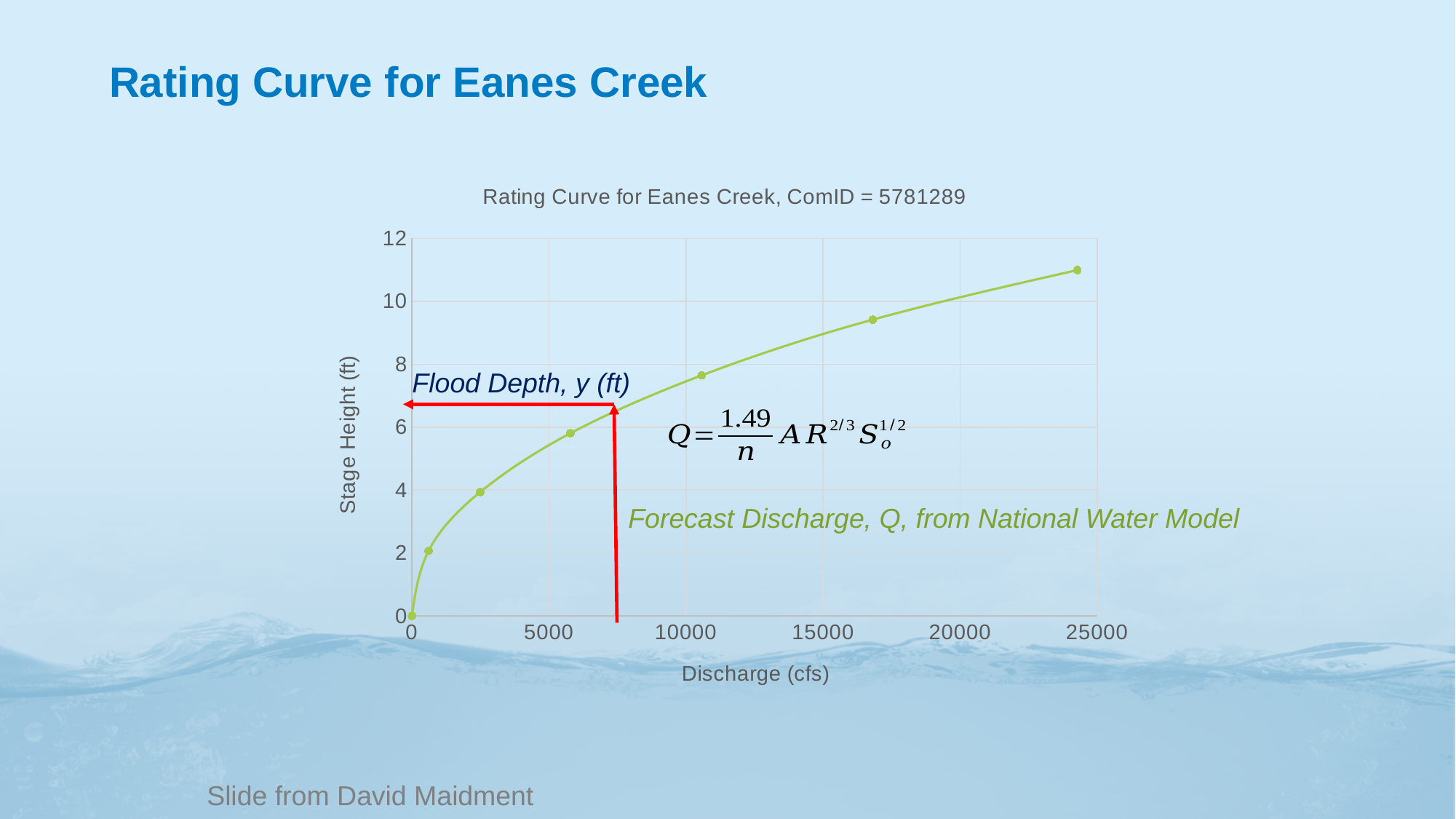
Is the stage height at the highest-discharge point greater or less than 10? greater What is the label of the x axis? Discharge (cfs) Is the stage height at a discharge of 15000 cfs greater or less than 8? greater What is the title printed above the chart? Rating Curve for Eanes Creek, ComID = 5781289 Is the discharge of the rightmost data point greater or less than 20000 cfs? greater What kind of chart is shown on the slide? line chart How many data points are marked on the curve? 7 Does stage height rise or fall as discharge increases along the x axis? rise Which data point has the highest stage height, the one at the lowest discharge or the one at the highest discharge? the one at the highest discharge What is the highest value shown on the y axis? 12